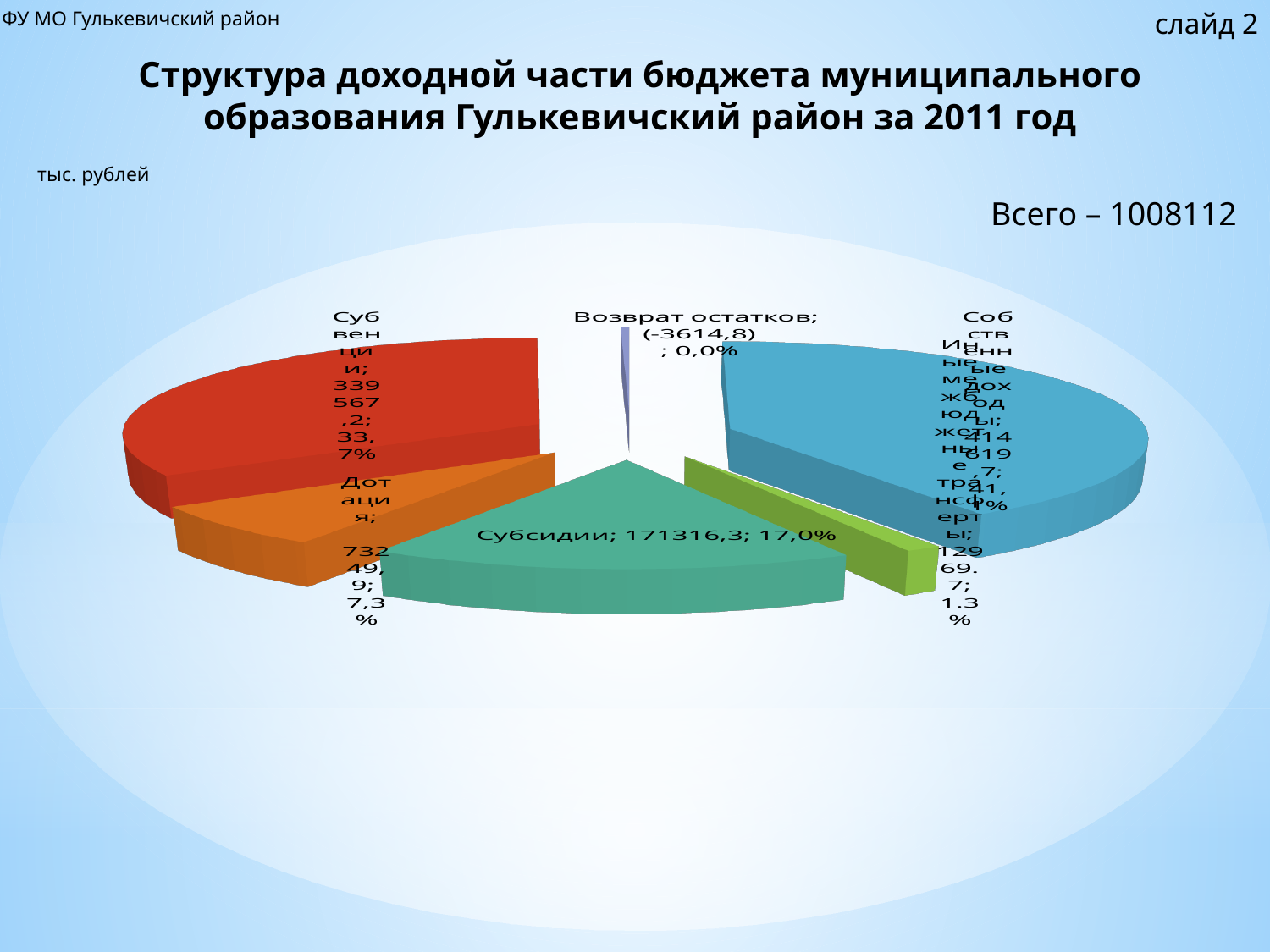
Which category has the smallest share of the pie? Возврат остатков What share of the pie does Субсидии represent? 17,0% What is the value for Дотация? 73249,9 Which is larger, the value for Субсидии or the value for Дотация? Субсидии What share of the pie does Субвенции represent? 33,7% What total (Всего) is stated on the slide? 1008112 What is the value for Субвенции? 339567,2 What share of the pie does Возврат остатков represent? 0,0% Which category has the largest share of the pie? Собственные доходы What kind of chart is shown on the slide? pie chart How many slices does the pie chart have? 6 What is the value for Субсидии? 171316,3